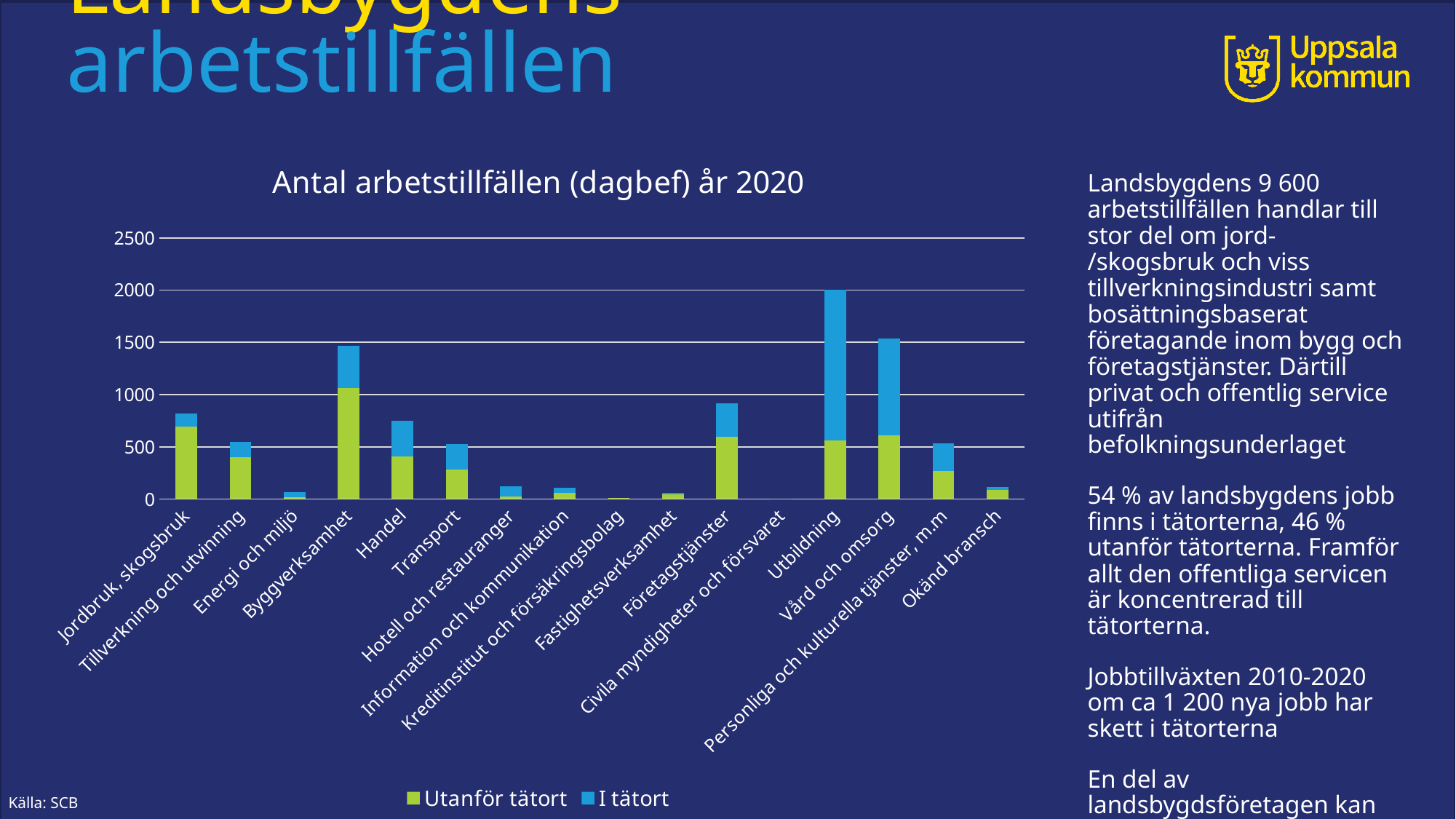
How many series does the chart's legend list? 2 Which has a larger total bar, Utbildning or Vård och omsorg? Utbildning What kind of chart is shown on the slide? Stacked bar chart Is the total value for Handel greater or less than 1000? less For Jordbruk, skogsbruk, which series makes up the larger part of the bar, Utanför tätort or I tätort? Utanför tätort Is the total value for Byggverksamhet greater or less than 1000? greater Is the total value for Utbildning greater or less than 1500? greater Which two series are listed in the chart's legend? Utanför tätort and I tätort Which category has the highest total bar in the chart? Utbildning Which has a larger total bar, Byggverksamhet or Handel? Byggverksamhet How many categories (branscher) are shown on the x axis of the chart? 16 What is the title of the chart? Antal arbetstillfällen (dagbef) år 2020